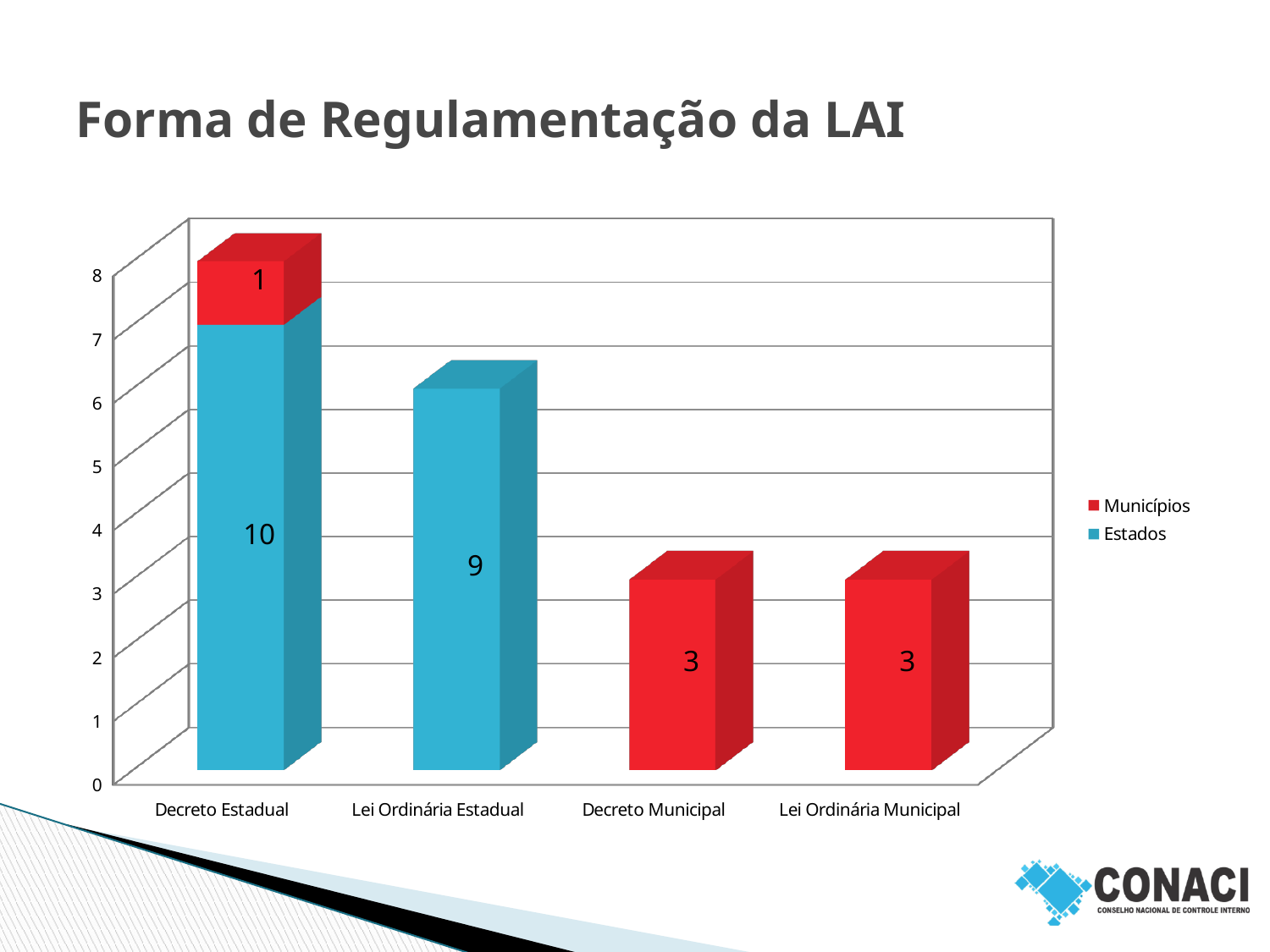
How many series does the legend list? 2 What is the value for Municípios in the Decreto Municipal category? 3 Which is larger: the Estados value for Lei Ordinária Estadual or the Municípios value for Decreto Municipal? Lei Ordinária Estadual What kind of chart is shown on the slide? Stacked bar chart What is the value for Municípios in the Decreto Estadual category? 1 Which category has the highest Estados value? Decreto Estadual What is the value for Municípios in the Lei Ordinária Municipal category? 3 What is the difference between the Estados values for Decreto Estadual and Lei Ordinária Estadual? 1 How many categories are shown on the x axis? 4